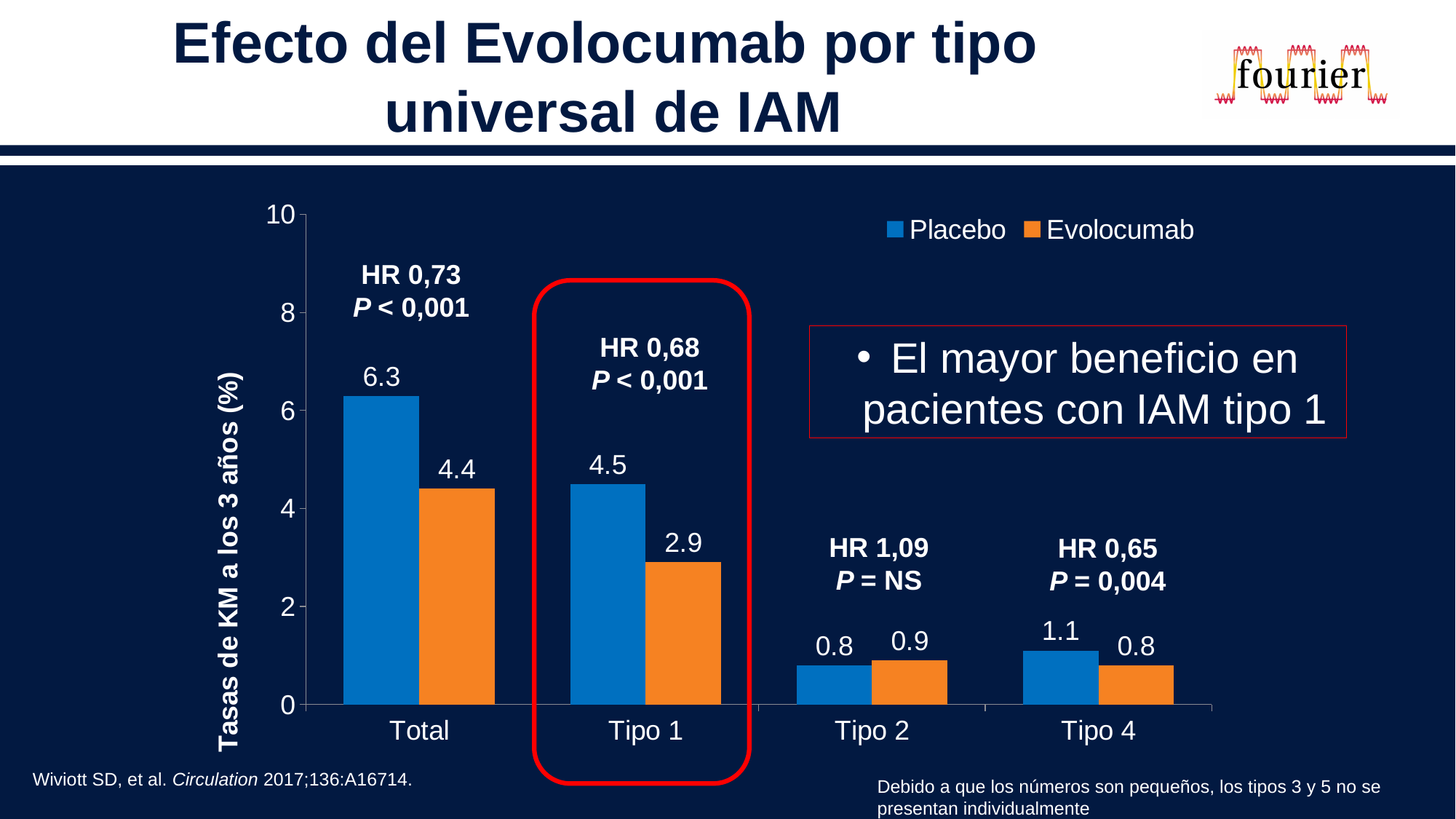
What is the Placebo value for Total? 6.3 How many categories are shown on the x axis? 4 Which category has the lowest Evolocumab value? Tipo 4 What kind of chart is shown on the slide? Bar chart What is the Placebo value for Tipo 4? 1.1 How many series does the legend list? 2 What is the Evolocumab value for Tipo 1? 2.9 What is the y-axis label of the chart? Tasas de KM a los 3 años (%) What is the difference between the Placebo and Evolocumab values for Total? 1.9 For Tipo 2, which is larger: the Placebo value or the Evolocumab value? Evolocumab Which category has the highest Placebo value? Total What is the difference between the Placebo and Evolocumab values for Tipo 1? 1.6